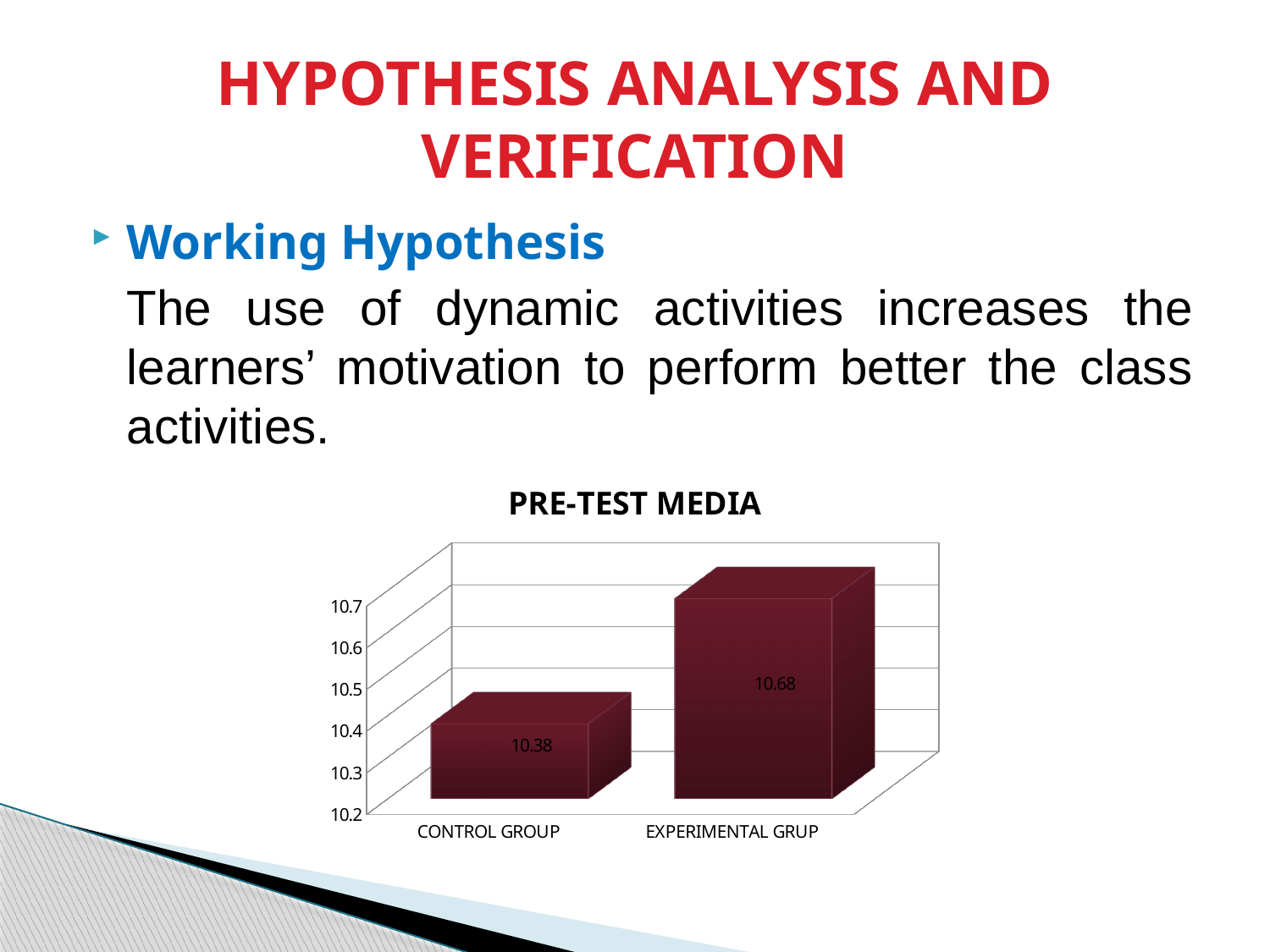
Is the value for CONTROL GROUP greater or less than 10.5? less What kind of chart is shown on the slide? bar chart What is the value for EXPERIMENTAL GRUP? 10.68 Is the value for EXPERIMENTAL GRUP greater or less than 10.5? greater What is the value for CONTROL GROUP? 10.38 Which category has the lowest value? CONTROL GROUP How many categories are shown on the chart? 2 What is the lowest value shown on the vertical axis? 10.2 Which is larger, the value for CONTROL GROUP or the value for EXPERIMENTAL GRUP? EXPERIMENTAL GRUP What is the difference between the EXPERIMENTAL GRUP and CONTROL GROUP values? 0.30 What is the title of the chart? PRE-TEST MEDIA Which category has the highest value? EXPERIMENTAL GRUP